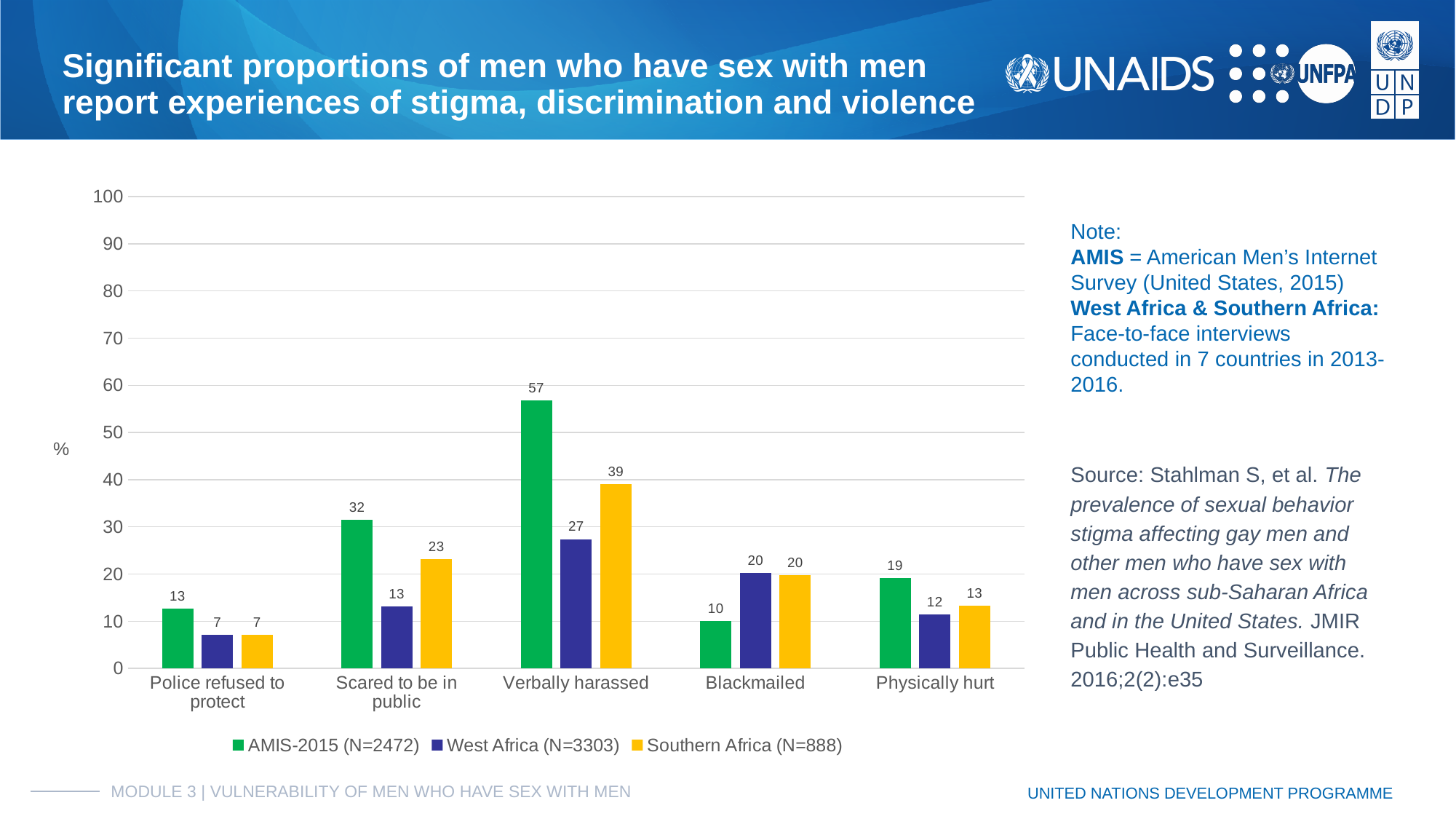
How many series does the legend list? 3 What is the value for Southern Africa (N=888) in the Scared to be in public category? 23 What is the value for West Africa (N=3303) in the Physically hurt category? 12 Which category has the highest value for the AMIS-2015 (N=2472) series? Verbally harassed What is the value for AMIS-2015 (N=2472) in the Verbally harassed category? 57 What is the difference between the AMIS-2015 (N=2472) and West Africa (N=3303) values in the Verbally harassed category? 30 What kind of chart is shown on the slide? Bar chart How many categories are shown on the x axis? 5 Is the value for Southern Africa (N=888) in the Verbally harassed category greater or less than 30? greater Which category has the lowest value for the Southern Africa (N=888) series? Police refused to protect In the Blackmailed category, which is larger: the AMIS-2015 (N=2472) value or the West Africa (N=3303) value? West Africa (N=3303) What label is shown on the vertical axis? %